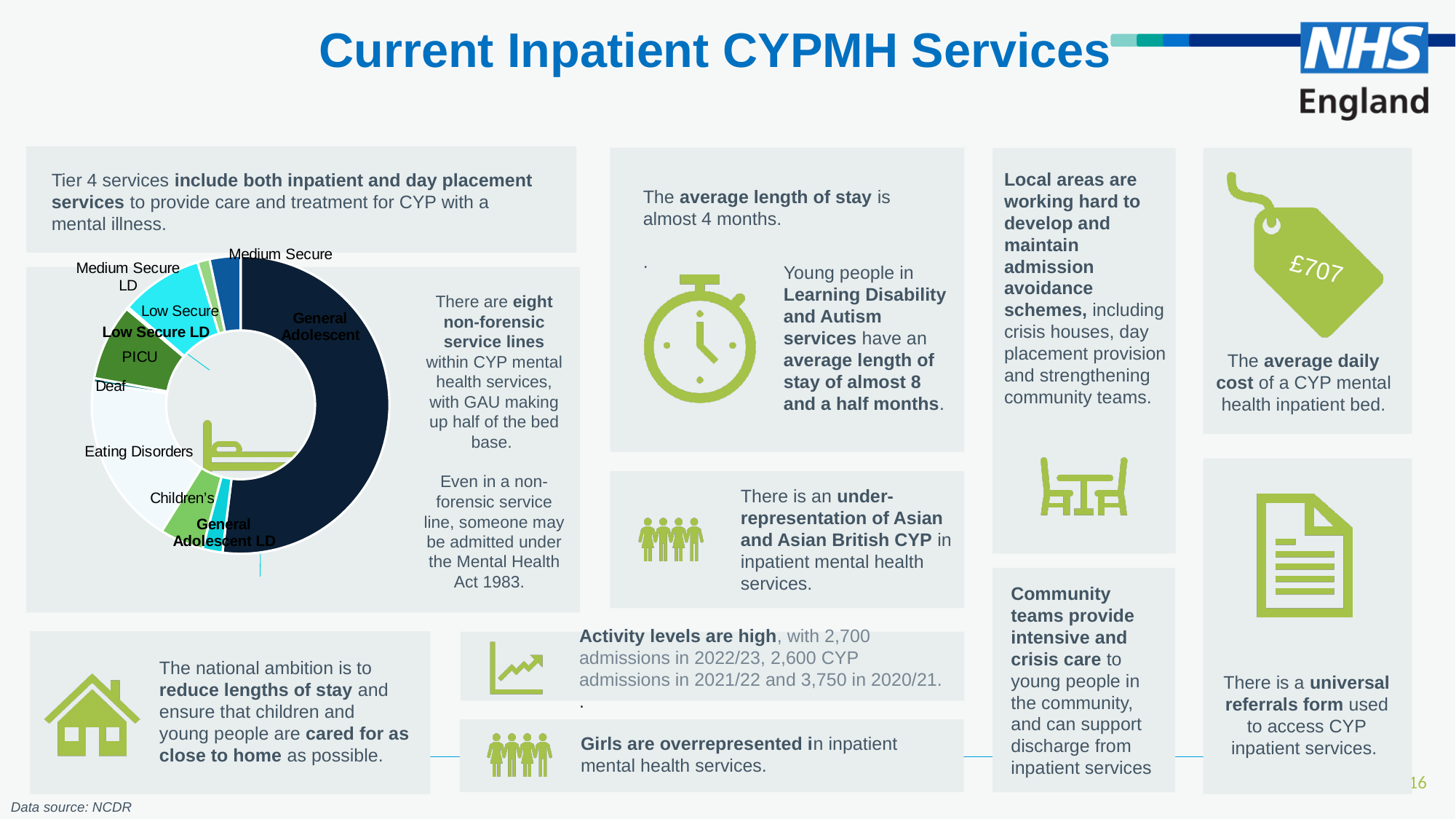
Which is larger in the donut chart, PICU or Deaf? PICU What icon is shown in the centre of the donut chart? A bed How many service line categories are labelled on the donut chart? 10 What colour is the General Adolescent segment of the donut chart? Dark navy blue Which service line has the second largest segment in the donut chart? Eating Disorders Which is larger in the donut chart, Eating Disorders or PICU? Eating Disorders What kind of chart is shown on the slide? Donut (pie) chart Which is larger in the donut chart, Eating Disorders or Children's? Eating Disorders Which service line has the largest segment in the donut chart? General Adolescent